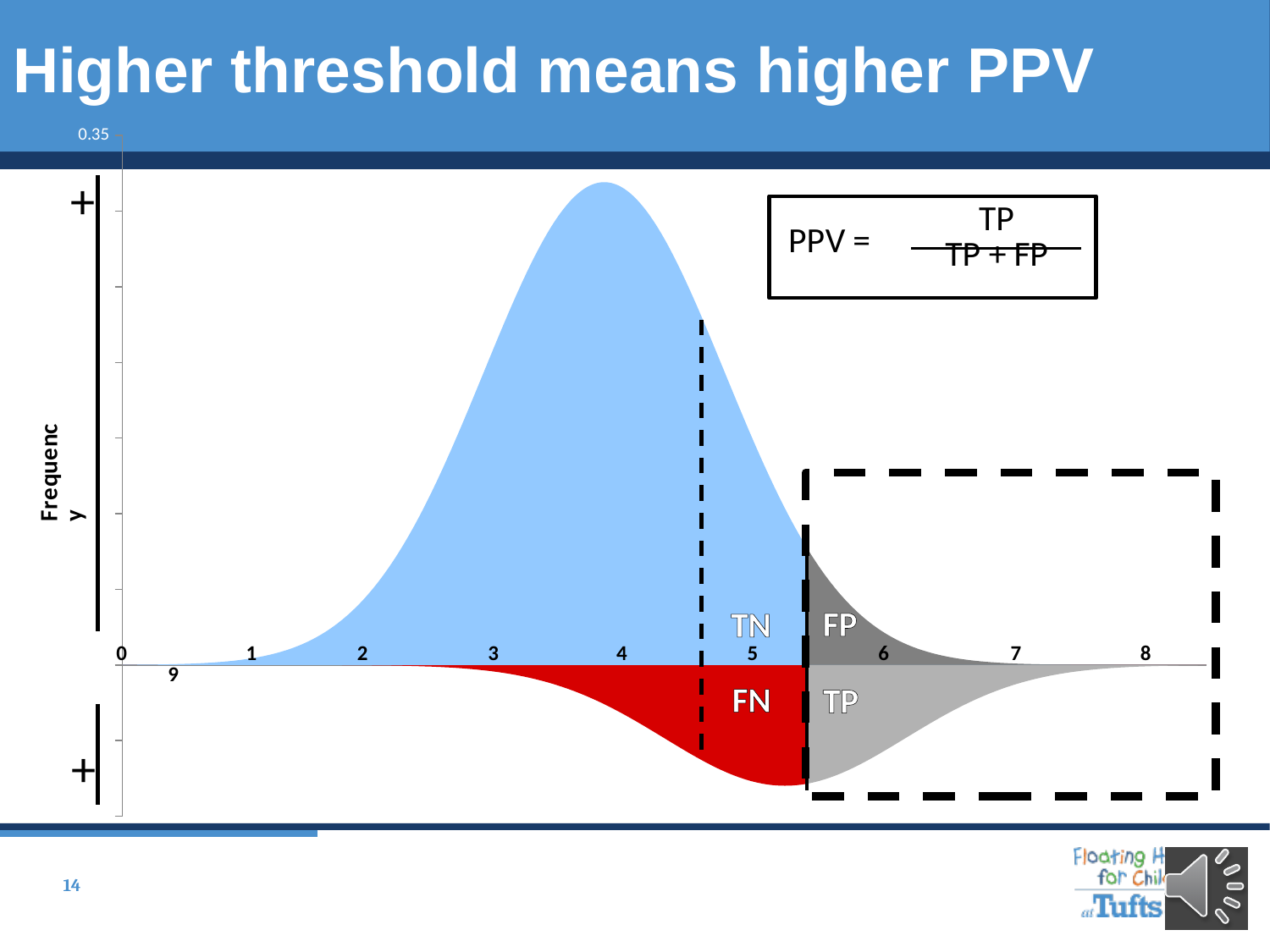
Which labelled region of the chart is shaded red? FN Does the light blue curve rise or fall as x goes from 4 to 8? fall What is the label on the y axis of the chart? Frequency Which labelled region of the chart covers the largest area? TN How many tick labels are shown along the x axis of the chart? 10 Does the light blue curve rise or fall as x goes from 0 to 4? rise Which region covers a larger area, FN or TP? FN Which region covers a larger area, TN or FP? TN What kind of chart is shown on the slide? area chart